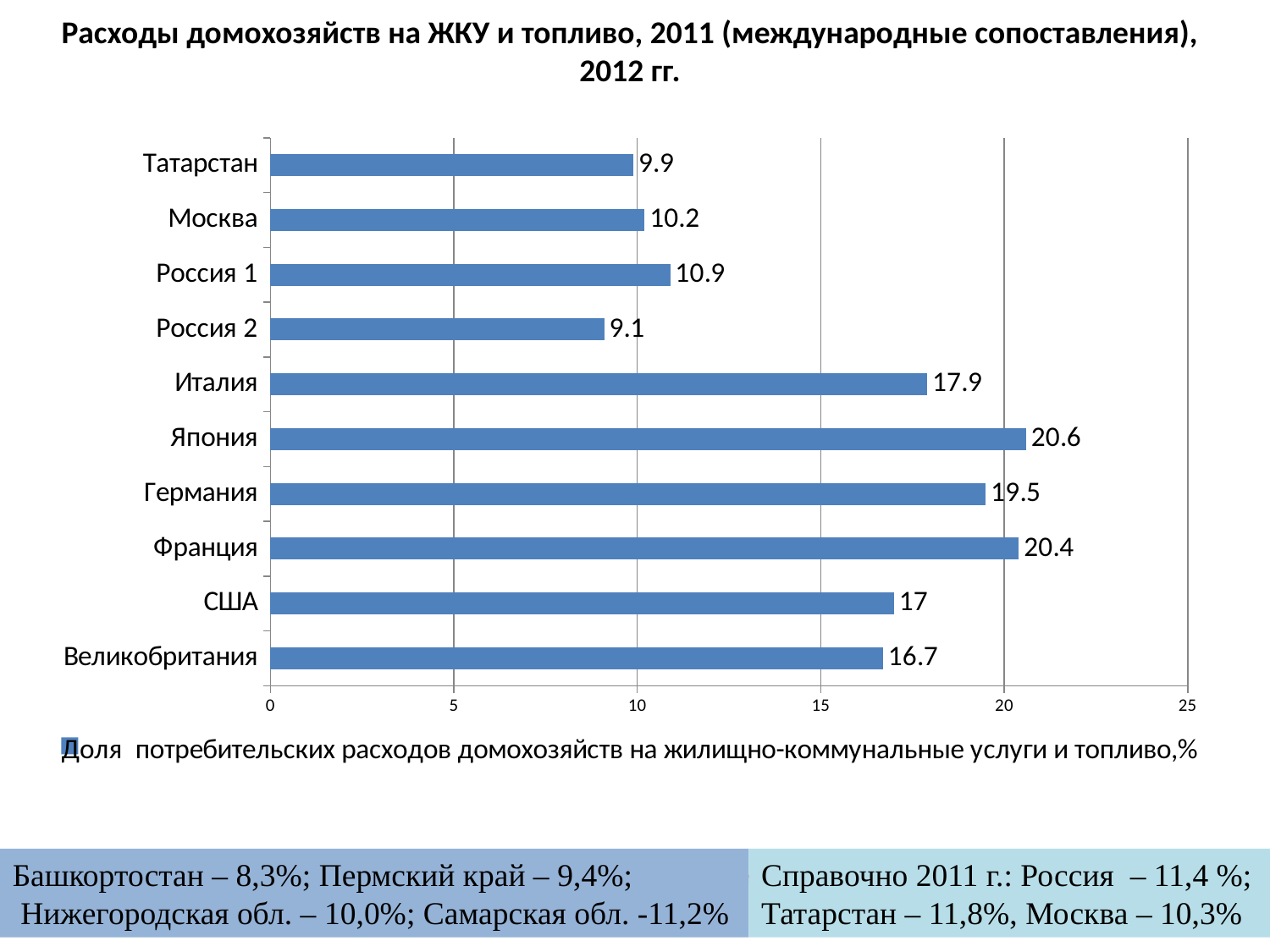
What is the value for Россия 2? 9.1 Which category has the lowest value? Россия 2 What is the value for Япония? 20.6 What is the value for Великобритания? 16.7 Is the value for Москва greater or less than 15? less Which is larger, the value for США or the value for Великобритания? США What is the difference between the values for Россия 1 and Татарстан? 1 How many categories are shown in the chart? 10 Which category has the highest value? Япония How many series does the legend list? 1 What is the difference between the values for Германия and Италия? 1.6 What type of chart is shown on the slide? Bar chart